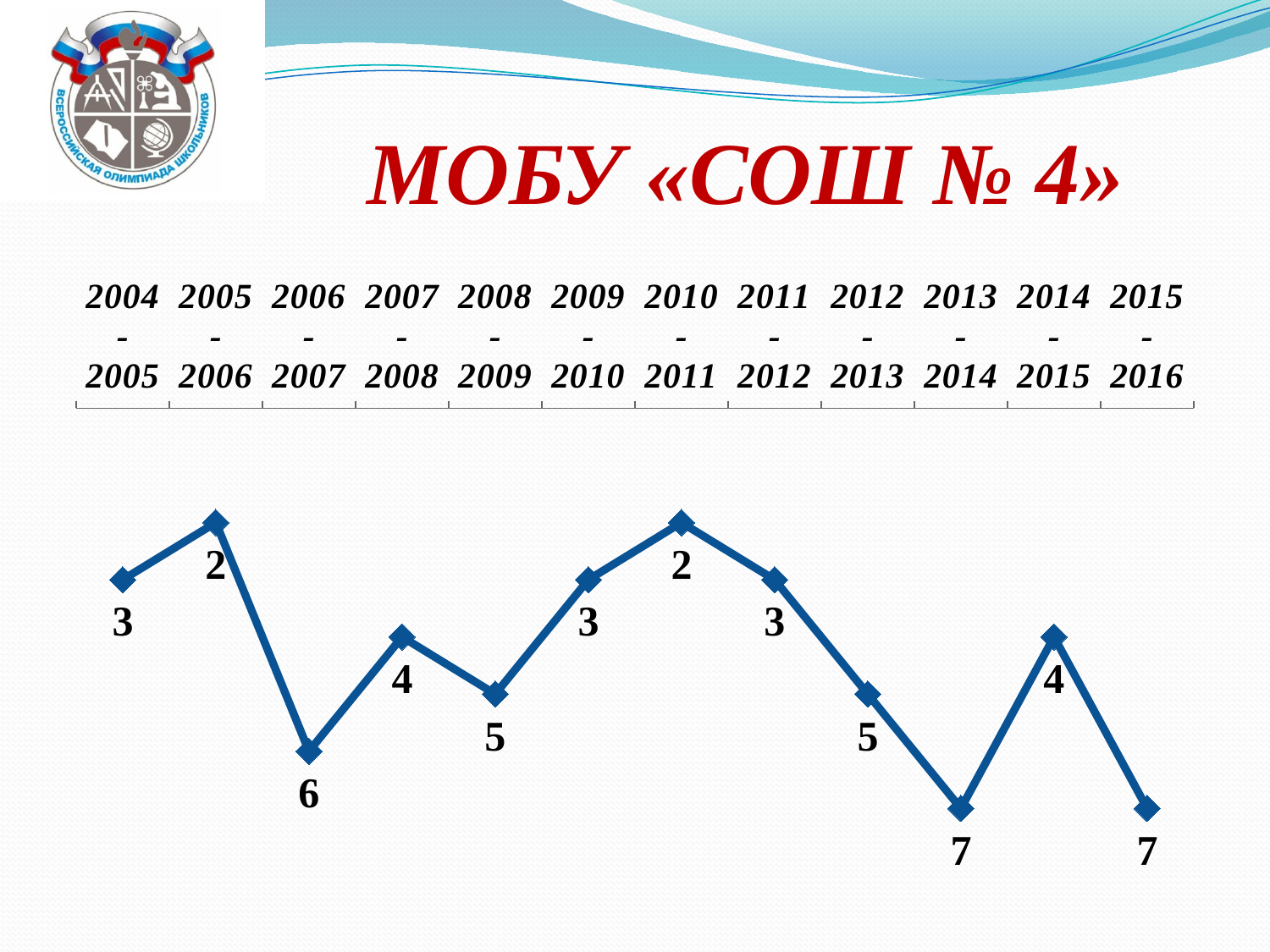
What is the title of the slide? МОБУ «СОШ № 4» What is the difference between the values for 2013-2014 and 2014-2015? 3 What is the value for 2006-2007? 6 What is the value for 2014-2015? 4 What is the value for 2010-2011? 2 What is the value for 2004-2005? 3 How many data points are plotted on the chart? 12 What is the difference between the values for 2006-2007 and 2007-2008? 2 What is the value for 2013-2014? 7 Does the value rise or fall from 2011-2012 to 2013-2014? rise What kind of chart is shown on the slide? line chart Which has the larger value, 2008-2009 or 2009-2010? 2008-2009